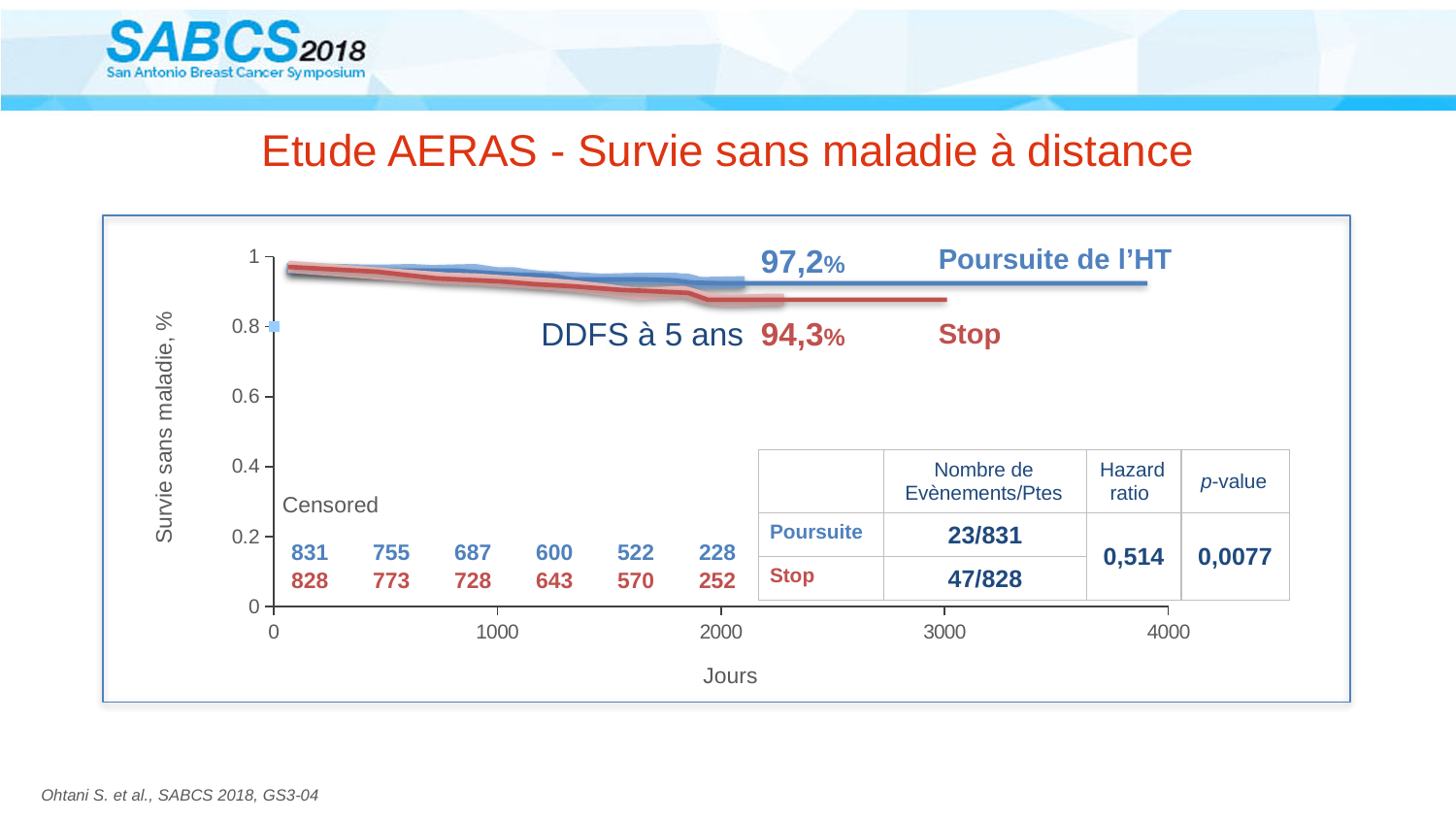
Do the survival curves rise or fall as the number of days increases? Fall How many groups (curves) are plotted on the chart? 2 What is the label of the x axis? Jours Which group has the higher 5-year DDFS, Poursuite de l'HT or Stop? Poursuite de l'HT What is the label of the y axis? Survie sans maladie, % What is the difference in 5-year DDFS between the Poursuite de l'HT and Stop groups? 2,9% What is the hazard ratio reported in the table on the chart? 0,514 What kind of chart is shown on the slide? Line chart (survival curve) What is the 5-year DDFS value shown for the Poursuite de l'HT group? 97,2% What is the first number at risk shown for the Poursuite (blue) group at day 0? 831 What is the number of events/patients for the Stop group? 47/828 What is the 5-year DDFS value shown for the Stop group? 94,3%